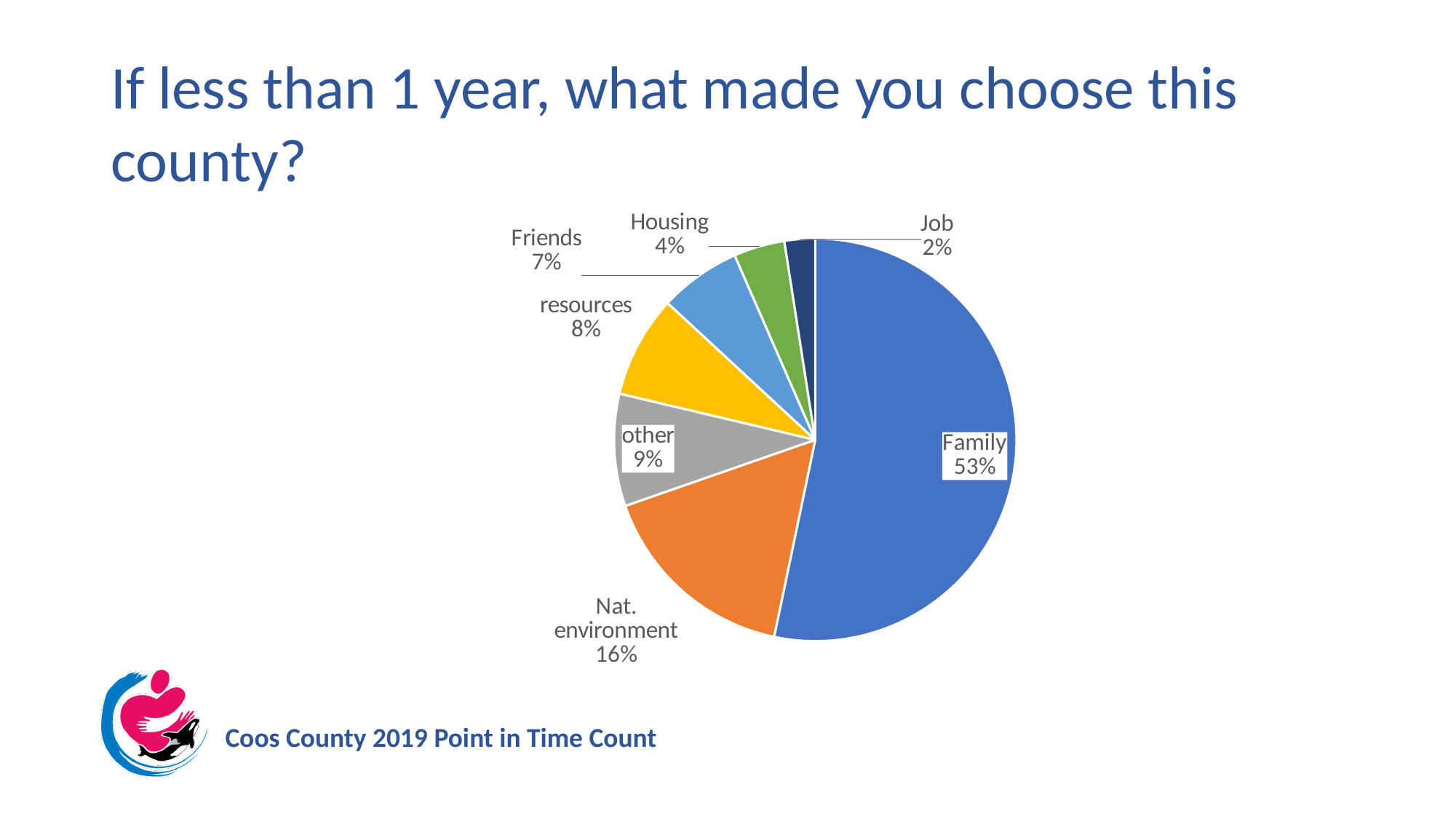
What share of the pie does Family account for? 53% What percentage is shown for Nat. environment? 16% Which is larger, the share for Friends or the share for other? other How many categories are shown in the pie chart? 7 What is the difference in percentage points between Family and Nat. environment? 37 What is the title of the slide containing the chart? If less than 1 year, what made you choose this county? What percentage is shown for resources? 8% What is the difference in percentage points between resources and Housing? 4 What percentage is shown for Housing? 4% Which category has the smallest slice of the pie? Job What kind of chart is shown on the slide? pie chart Which category has the largest slice of the pie? Family